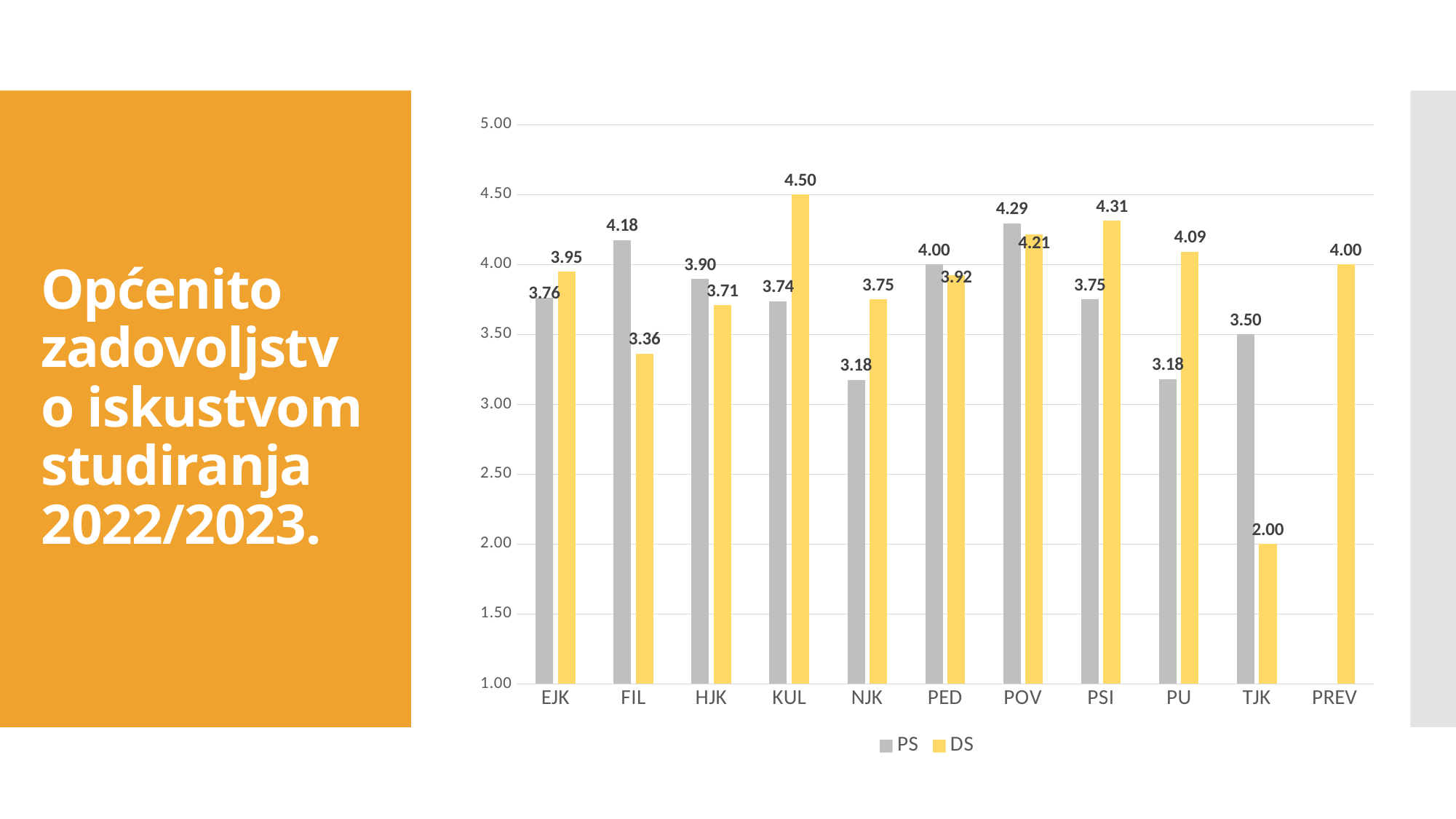
What is the DS value for KUL? 4.50 Which is larger for PSI, the PS value or the DS value? DS How many categories are shown on the x axis? 11 Which category has the highest DS value? KUL What is the PS value for FIL? 4.18 Which category has the lowest DS value? TJK What type of chart is shown on the slide? Bar chart How many series does the legend list? 2 What is the difference between the PS and DS values for TJK? 1.50 What is the difference between the PS and DS values for FIL? 0.82 Which category has the highest PS value? POV What is the DS value for TJK? 2.00